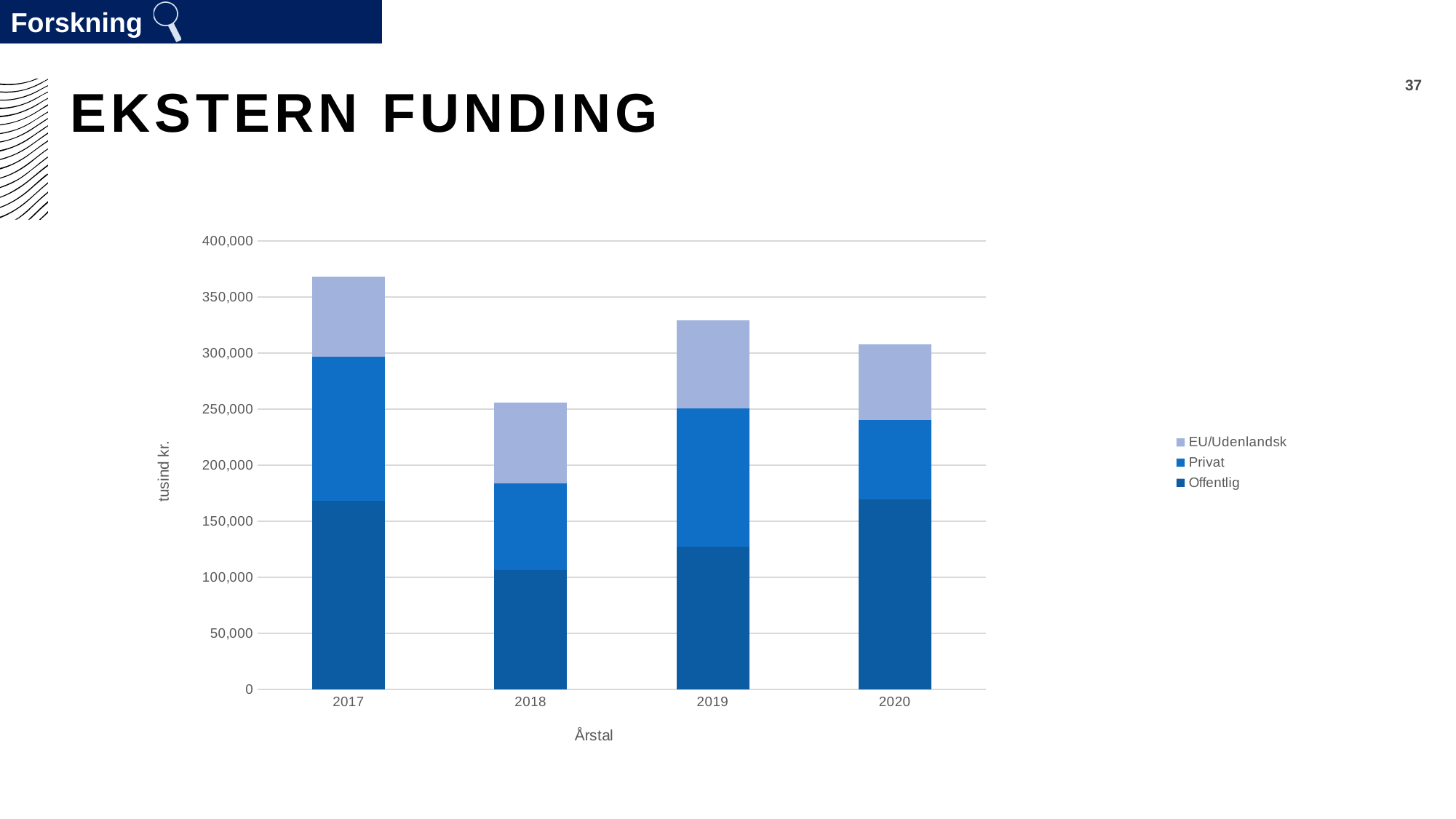
Which year has the highest total external funding? 2017 Is the total funding for 2017 greater or less than 350,000? greater How many years are shown on the x axis of the chart? 4 How many series does the chart's legend list? 3 Which year has the larger Offentlig value, 2018 or 2019? 2019 Is the total funding for 2018 greater or less than 300,000? less Which year has the larger total funding, 2019 or 2020? 2019 Is the Offentlig value for 2020 greater or less than 150,000? greater Which year has the lowest total external funding? 2018 What is the label on the y axis of the chart? tusind kr. What kind of chart is shown on the slide? Stacked bar chart